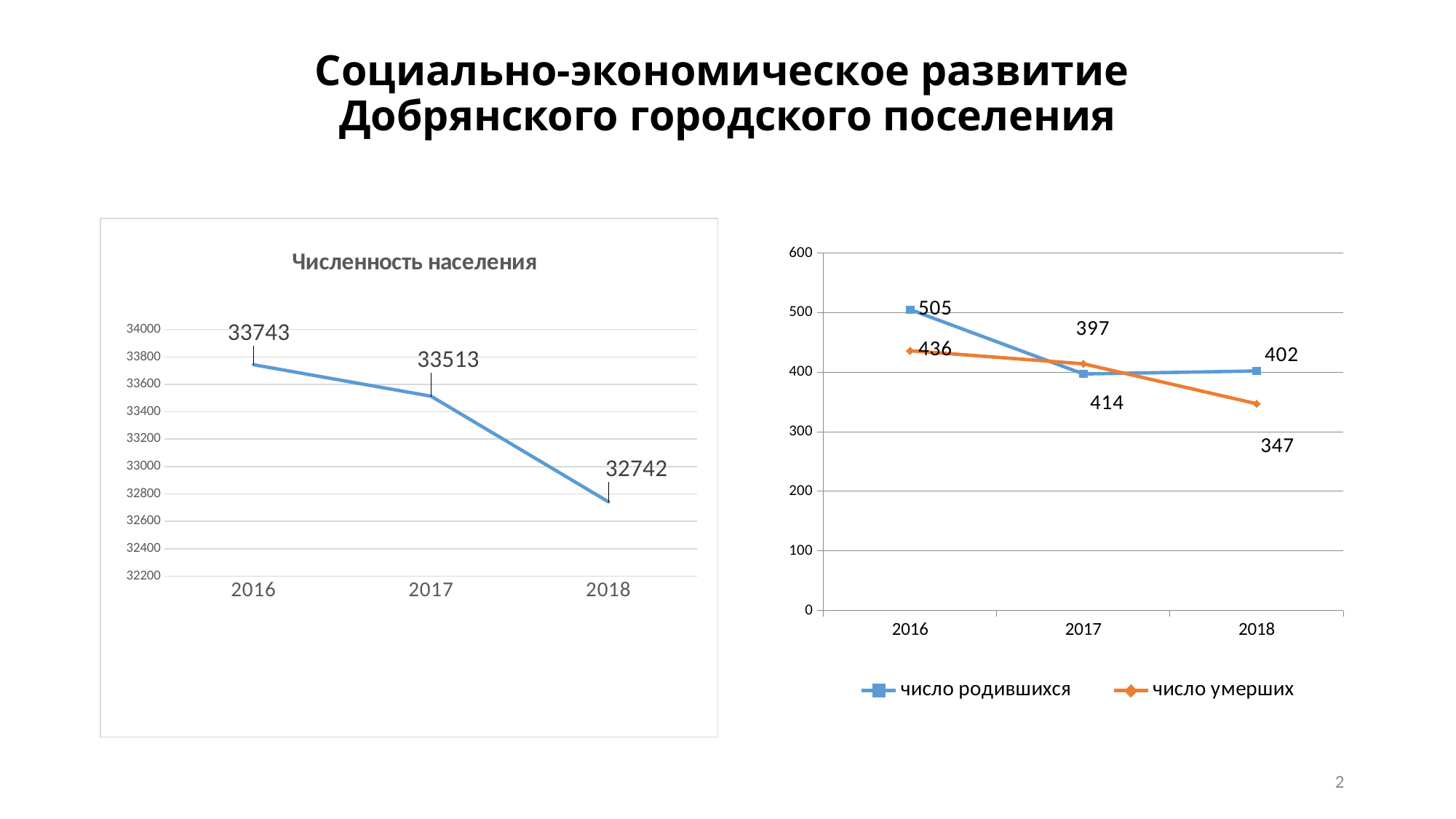
What kind of chart is the chart on the right? line chart In the chart on the right, what is the value of "число родившихся" in 2016? 505 In the chart titled "Численность населения", which year has the lowest value? 2018 In the chart titled "Численность населения", how many years are plotted? 3 In the chart titled "Численность населения", what is the value for 2018? 32742 In the chart titled "Численность населения", what is the value for 2016? 33743 In the chart titled "Численность населения", by how much does the value fall from 2017 to 2018? 771 In the chart on the right, what is the value of "число умерших" in 2018? 347 In the chart titled "Численность населения", do the values rise or fall from 2016 to 2018? fall In the chart on the right, how many series does the legend list? 2 In the chart on the right, what is the difference between "число родившихся" and "число умерших" in 2018? 55 In the chart on the right, which is larger in 2017: "число родившихся" or "число умерших"? число умерших